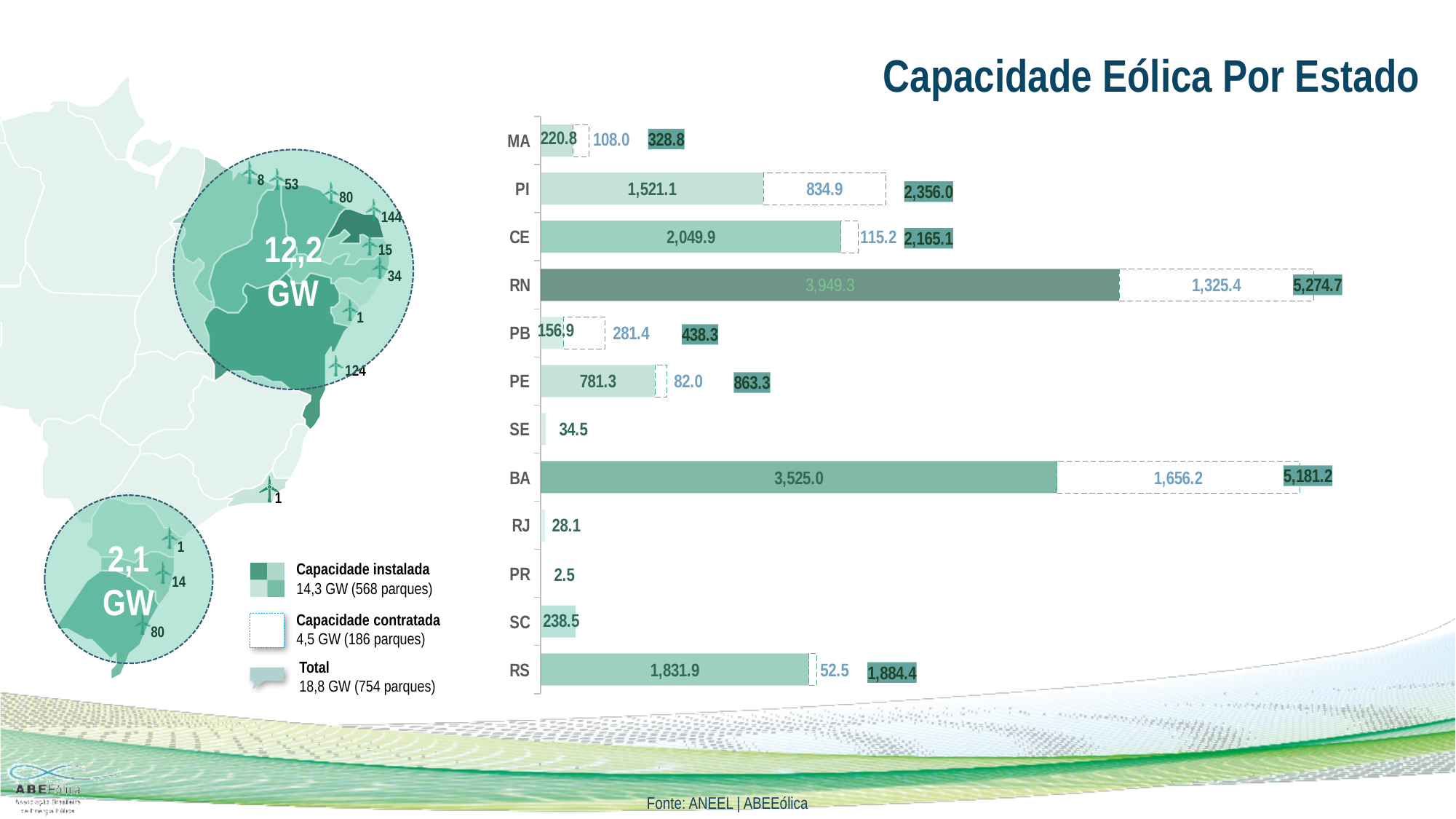
How many series does the legend list? 3 What is the installed capacity (Capacidade instalada) value shown for RN? 3,949.3 How many states are listed on the chart? 12 Which state has the highest total value? RN What is the difference between the installed capacity of RN (3,949.3) and BA (3,525.0)? 424.3 According to the legend, how many parques correspond to the Total of 18,8 GW? 754 parques What is the total value shown for PI? 2,356.0 Which state has the larger contracted capacity, PI or CE? PI What is the contracted capacity (Capacidade contratada) value shown for BA? 1,656.2 What type of chart is shown on the slide? bar chart What is the total value shown for PE? 863.3 Which state has the lowest value on the chart? PR